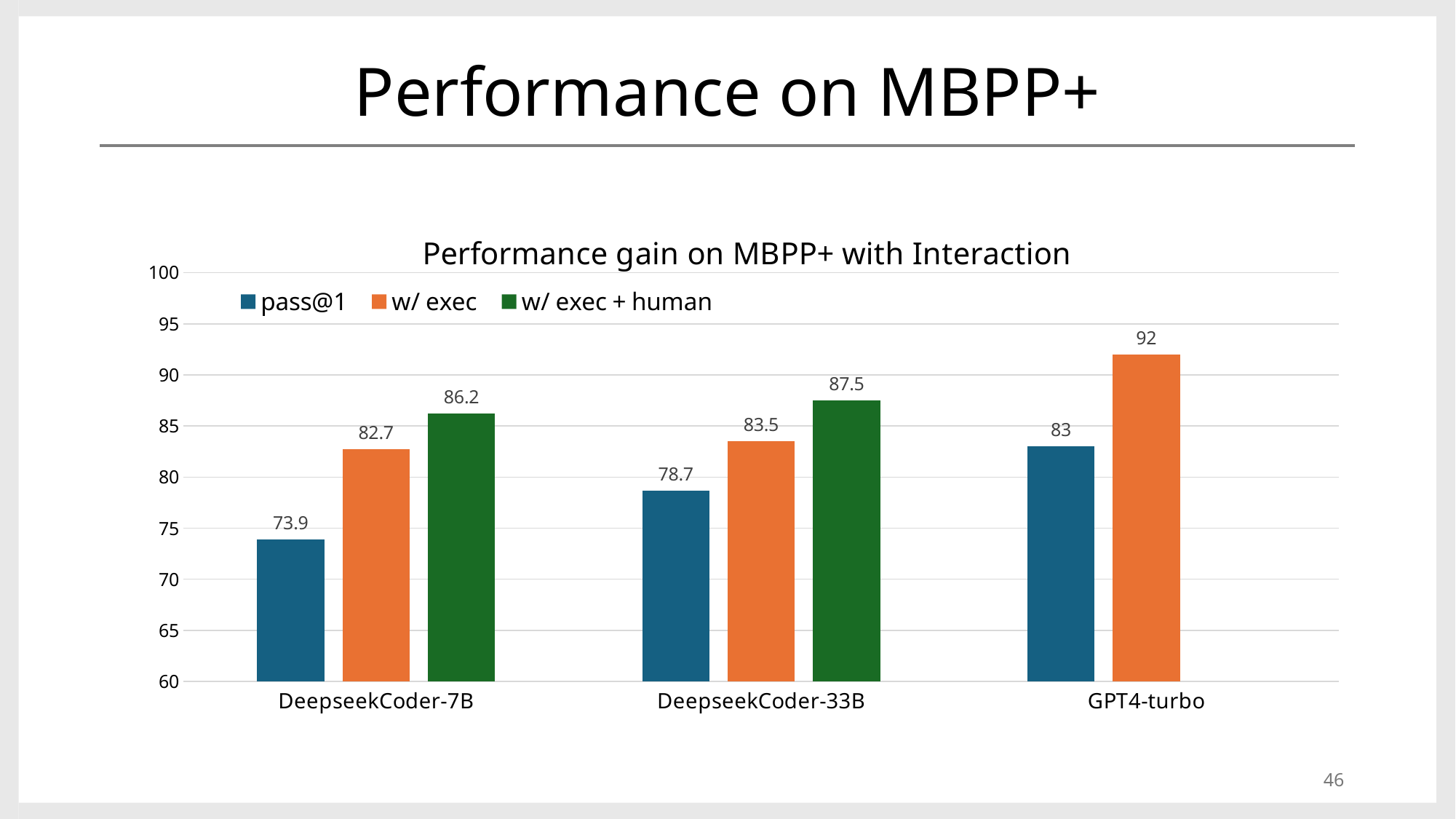
What is the pass@1 value for DeepseekCoder-7B? 73.9 Which model has the highest pass@1 value? GPT4-turbo What is the title of the chart? Performance gain on MBPP+ with Interaction What is the w/ exec + human value for DeepseekCoder-33B? 87.5 What is the w/ exec value for GPT4-turbo? 92 Is the w/ exec + human value for DeepseekCoder-7B greater or less than 85? greater Which model has the lowest w/ exec value? DeepseekCoder-7B How many series does the legend list? 3 Which is larger: the w/ exec value for DeepseekCoder-33B or the pass@1 value for GPT4-turbo? w/ exec value for DeepseekCoder-33B What is the difference between the w/ exec and pass@1 values for DeepseekCoder-7B? 8.8 How many models are shown on the x axis? 3 What kind of chart is shown? bar chart